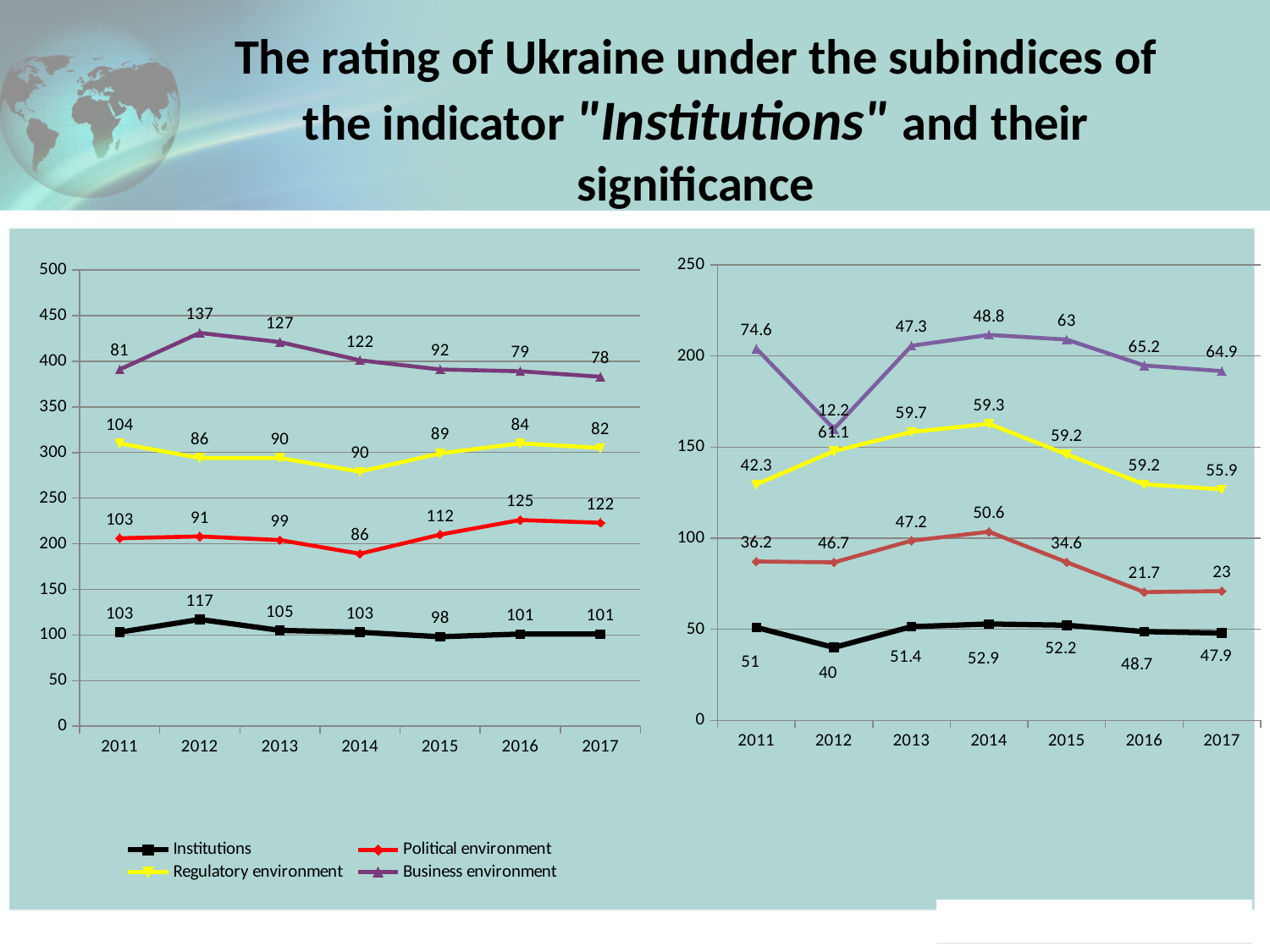
How many years are shown on the x axis of the left chart? 7 On the right chart, what is the value of the black line in 2012? 40 On the left chart, in which year is the Political environment value highest? 2016 On the left chart, what is the value for Business environment in 2012? 137 What kind of chart is the left chart? line chart On the left chart, in which year is the Regulatory environment value lowest? 2017 How many series does the legend of the left chart list? 4 On the right chart, what is the value of the yellow line in 2014? 59.3 On the right chart, in which year is the purple line at its lowest value? 2012 On the left chart, what is the difference between the Business environment values in 2012 and 2017? 59 On the right chart, is the red line's value larger in 2014 or in 2016? 2014 On the left chart, what is the value for Institutions in 2012? 117